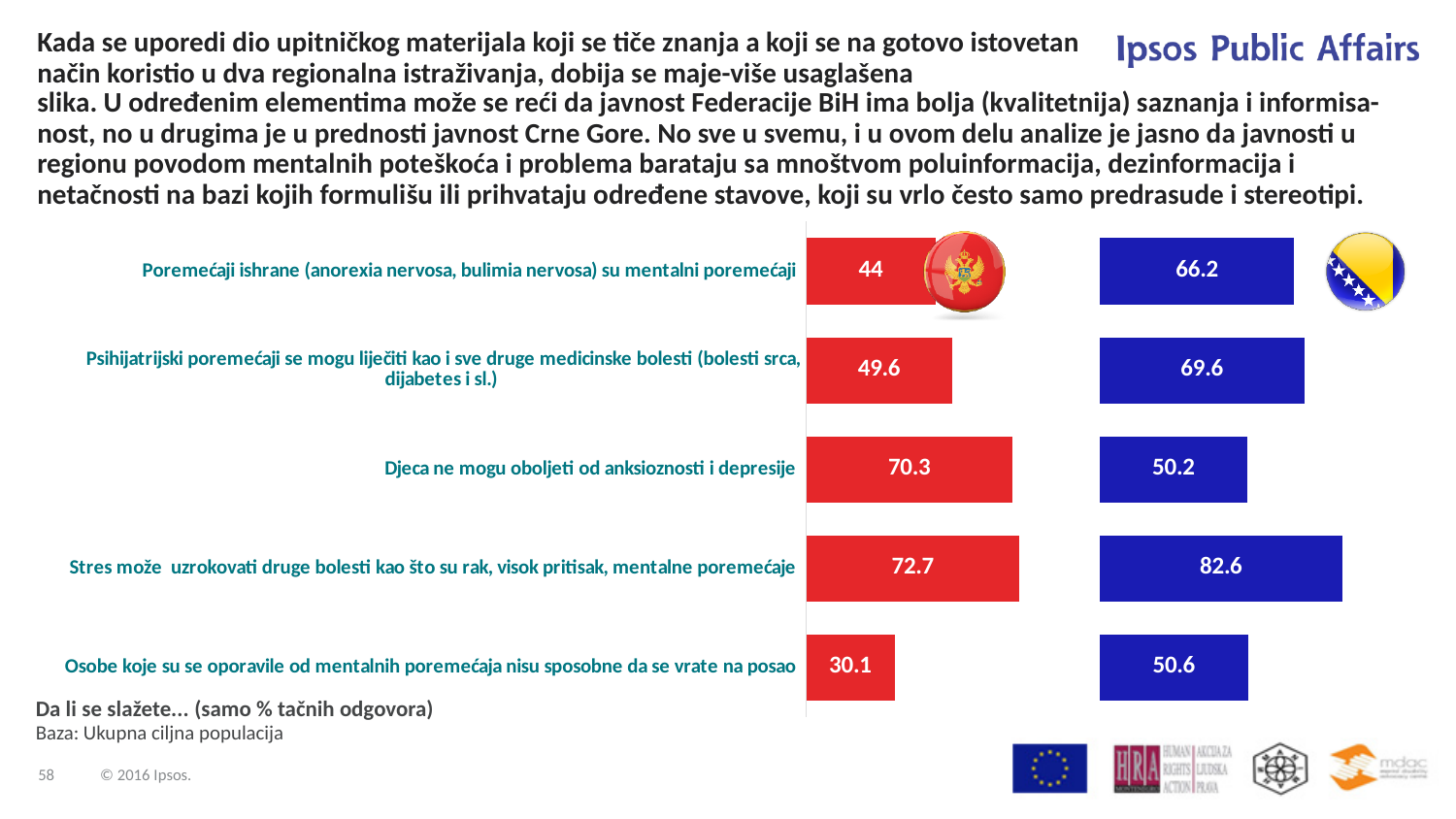
How many categories are shown in the left chart with red bars? 5 What type of chart is used on this slide? Bar chart In the right chart with blue bars, what is the value for "Stres može uzrokovati druge bolesti kao što su rak, visok pritisak, mentalne poremećaje"? 82.6 In the right chart with blue bars, which category has the lowest value? Djeca ne mogu oboljeti od anksioznosti i depresije In the left chart with red bars, what is the value for "Djeca ne mogu oboljeti od anksioznosti i depresije"? 70.3 For "Djeca ne mogu oboljeti od anksioznosti i depresije", which is larger: the red-bar value or the blue-bar value? The red-bar value In the left chart with red bars, which category has the lowest value? Osobe koje su se oporavile od mentalnih poremećaja nisu sposobne da se vrate na posao What is the difference between the red-bar value and the blue-bar value for "Osobe koje su se oporavile od mentalnih poremećaja nisu sposobne da se vrate na posao"? 20.5 In the left chart with red bars, what is the value for "Osobe koje su se oporavile od mentalnih poremećaja nisu sposobne da se vrate na posao"? 30.1 What is the difference between the blue-bar value and the red-bar value for "Psihijatrijski poremećaji se mogu liječiti kao i sve druge medicinske bolesti (bolesti srca, dijabetes i sl.)"? 20 In the right chart with blue bars, what is the value for "Poremećaji ishrane (anorexia nervosa, bulimia nervosa) su mentalni poremećaji"? 66.2 In the left chart with red bars, which category has the highest value? Stres može uzrokovati druge bolesti kao što su rak, visok pritisak, mentalne poremećaje